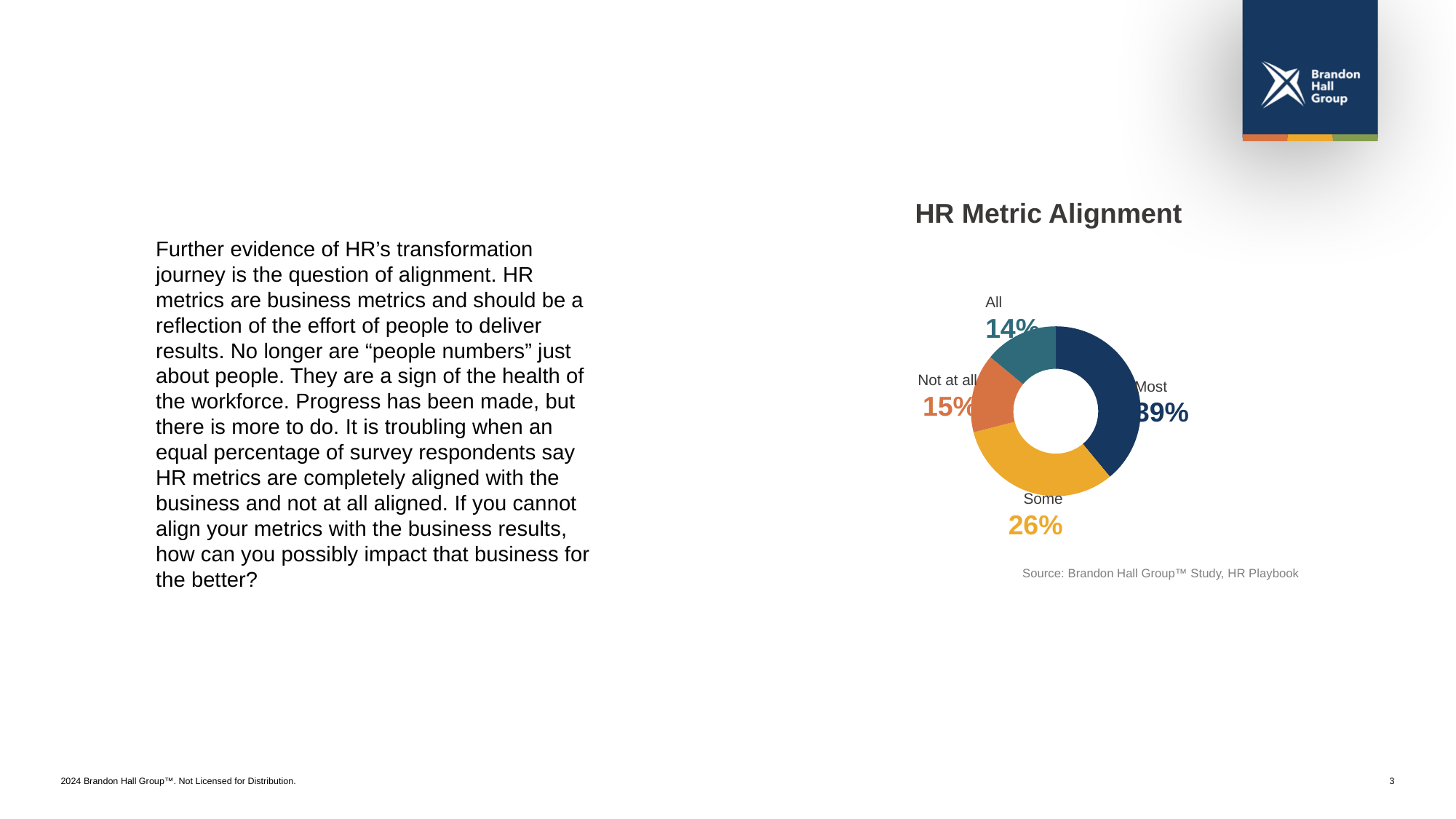
What is the title of the chart? HR Metric Alignment What percentage is shown for the "All" slice? 14% What is the difference in percentage points between "Some" and "Not at all"? 11 Which category has the smallest share of the pie? All What colour is the "Some" slice of the pie chart? Yellow/orange What percentage is shown for the "Not at all" slice? 15% What percentage is shown for the "Most" slice? 39% What percentage of respondents say HR metrics are "Some" aligned? 26% What type of chart is shown under the title "HR Metric Alignment"? Pie chart (donut) How many categories are shown in the pie chart? 4 Which category has the largest share of the pie? Most Which is larger, the share for "Some" or the share for "All"? Some